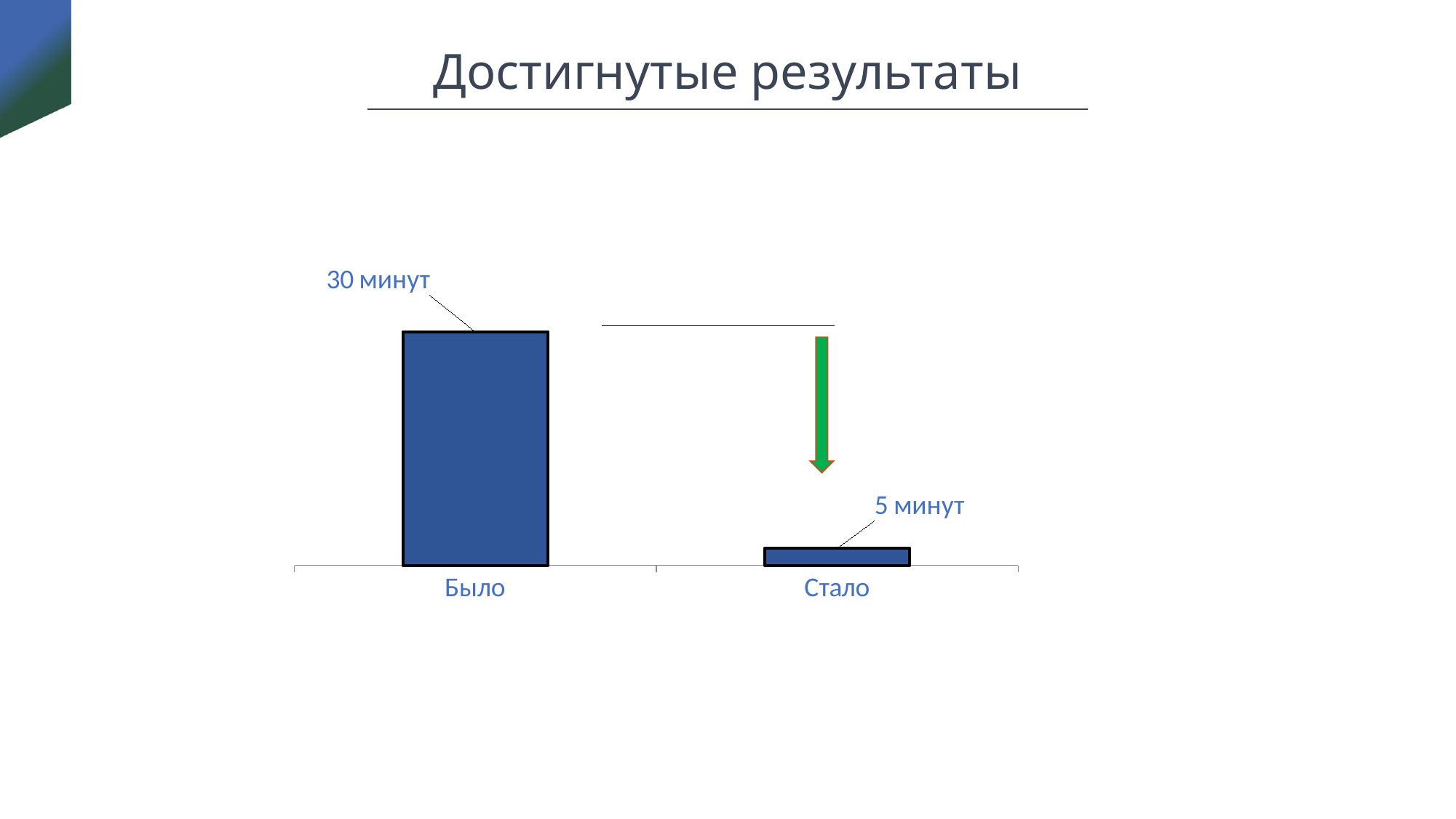
What is the title of the slide containing the chart? Достигнутые результаты Which is larger, the value for Было or the value for Стало? Было Which category has the lowest value? Стало What colour are the bars on the chart? Blue How many categories are shown on the chart? 2 What is the value for Стало? 5 минут Do the values rise or fall from Было to Стало? Fall What is the value for Было? 30 минут What is the difference between the values for Было and Стало? 25 минут What kind of chart is shown on the slide? Bar chart Which category has the highest value? Было